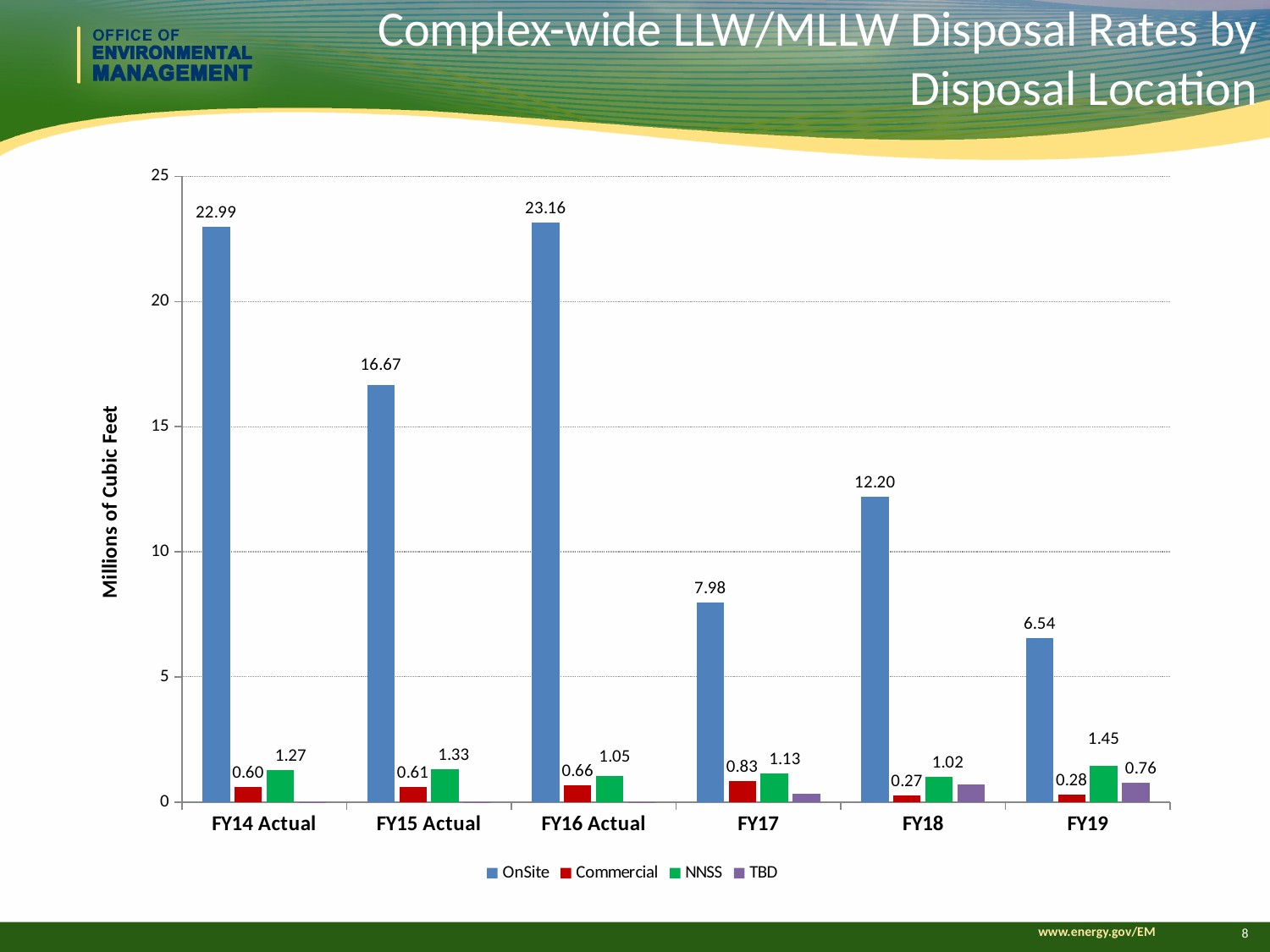
What is the OnSite value for FY16 Actual? 23.16 How many fiscal year categories are shown on the x axis? 6 Which fiscal year has the highest OnSite value? FY16 Actual How many series does the legend list? 4 Which fiscal year has the lowest Commercial value? FY18 Which is larger, the NNSS value for FY15 Actual or for FY16 Actual? FY15 Actual What kind of chart is shown on the slide? bar chart What is the Commercial value for FY17? 0.83 Is the OnSite value for FY18 greater or less than 10? greater What is the NNSS value for FY19? 1.45 Which fiscal year has the lowest OnSite value? FY19 What is the difference between the OnSite values for FY14 Actual and FY15 Actual? 6.32